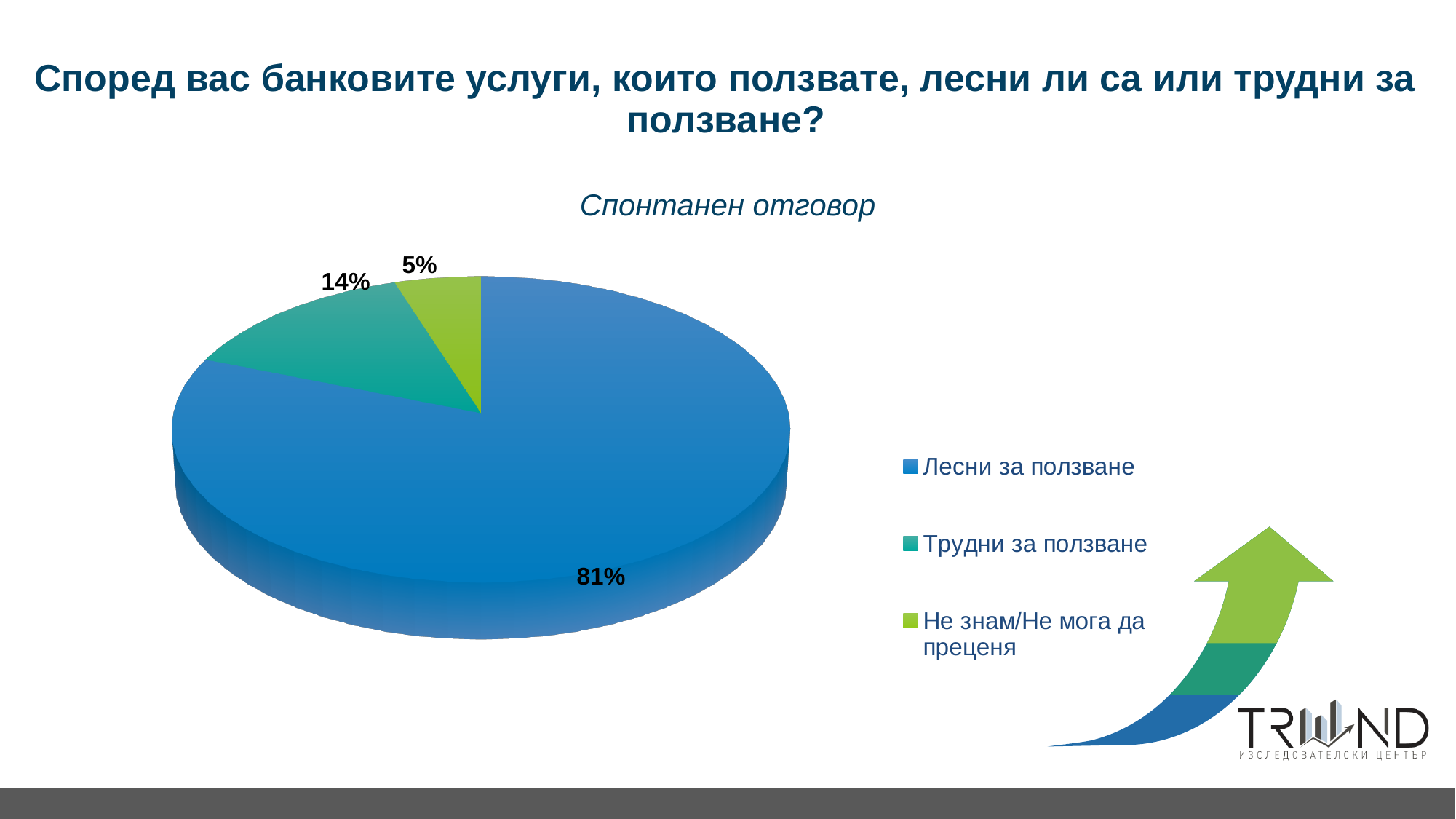
What colour is the slice for "Лесни за ползване"? Blue What is the difference in percentage points between "Лесни за ползване" and "Трудни за ползване"? 67 What share of respondents answered "Трудни за ползване"? 14% Which answer category has the smallest share of the pie? Не знам/Не мога да преценя How many categories does the pie chart show? 3 What is the subtitle shown above the pie chart? Спонтанен отговор What kind of chart is shown on the slide? Pie chart Which answer category has the largest share of the pie? Лесни за ползване Which is larger: the share for "Трудни за ползване" or for "Не знам/Не мога да преценя"? Трудни за ползване What is the difference in percentage points between "Трудни за ползване" and "Не знам/Не мога да преценя"? 9 What share of respondents answered "Не знам/Не мога да преценя"? 5% What share of respondents answered "Лесни за ползване"? 81%